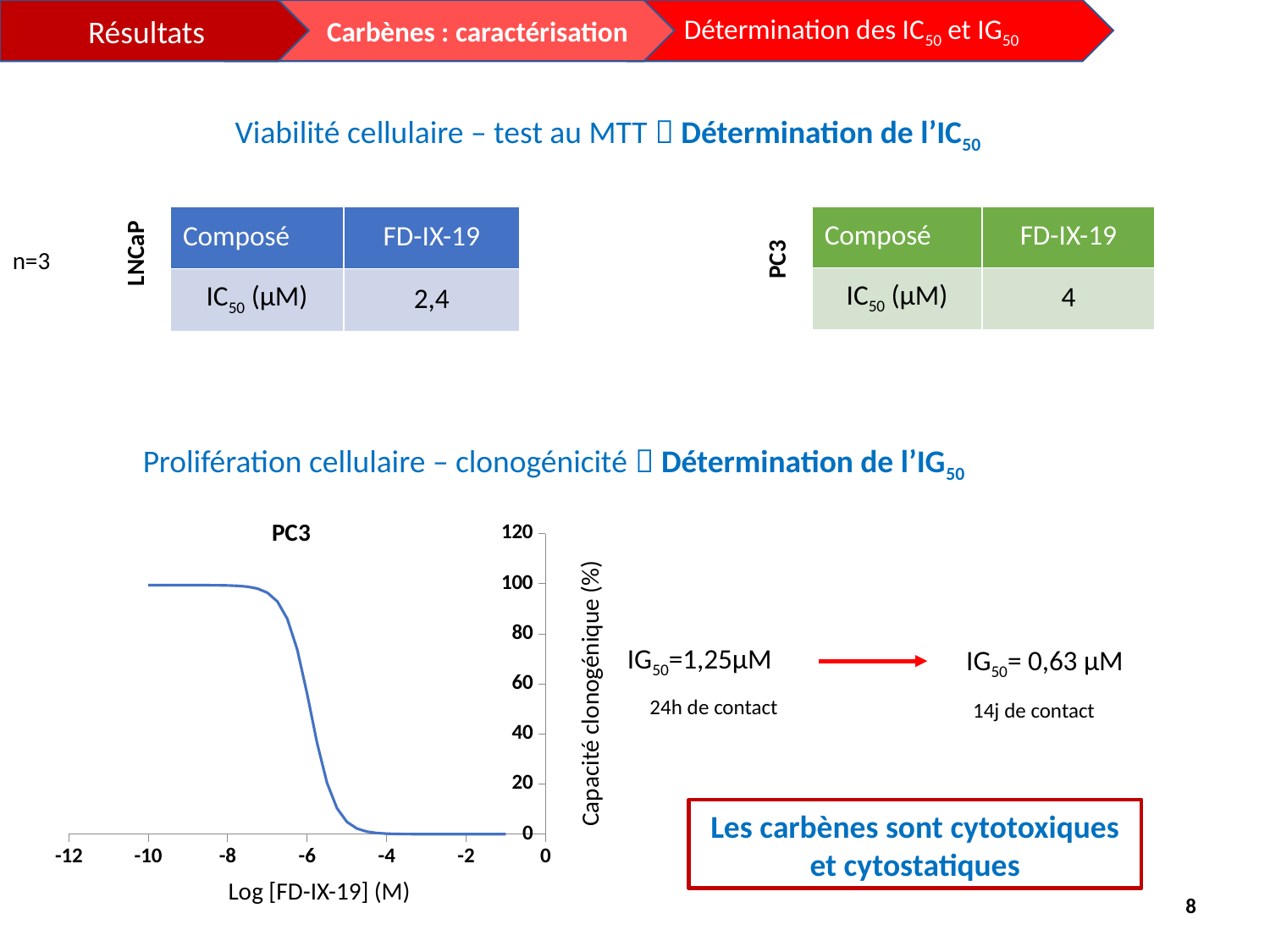
Which is larger: the curve's value at Log [FD-IX-19] = -8 or at -4? -8 What kind of chart is shown on the slide? line chart Is the value of the curve at Log [FD-IX-19] = -4 greater or less than 20? less What is the lowest tick value shown on the x axis? -12 Does the plotted curve rise or fall as the x-axis value increases from -10 to -4? fall How many tick labels are shown on the x axis? 7 Is the value of the curve at Log [FD-IX-19] = -10 greater or less than 80? greater How many lines are plotted on the chart? 1 What is the title of the chart? PC3 Is the value of the curve at Log [FD-IX-19] = -8 greater or less than 60? greater What is the highest tick value shown on the y axis? 120 What is the label of the chart's y axis? Capacité clonogénique (%)